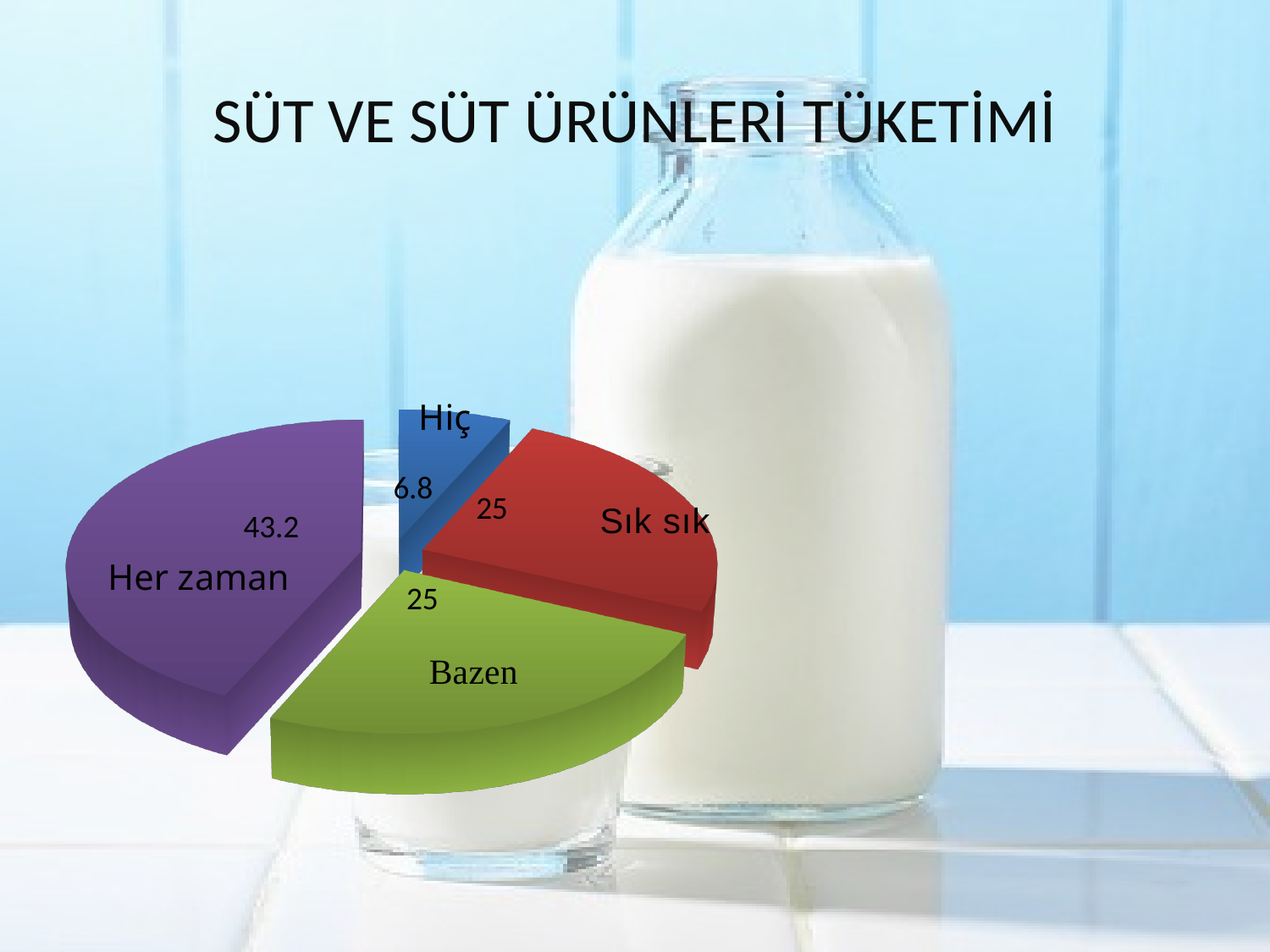
What is the value for Her zaman? 43.2 What is the difference between the values for Her zaman and Bazen? 18.2 How many slices does the pie chart have? 4 What is the title of the slide? SÜT VE SÜT ÜRÜNLERİ TÜKETİMİ What is the difference between the values for Her zaman and Hiç? 36.4 Which is larger, the value for Her zaman or the value for Sık sık? Her zaman What kind of chart is shown on the slide? Pie chart What is the value for Hiç? 6.8 Which category has the smallest slice? Hiç What is the value for Bazen? 25 Which category has the largest slice? Her zaman What is the value for Sık sık? 25